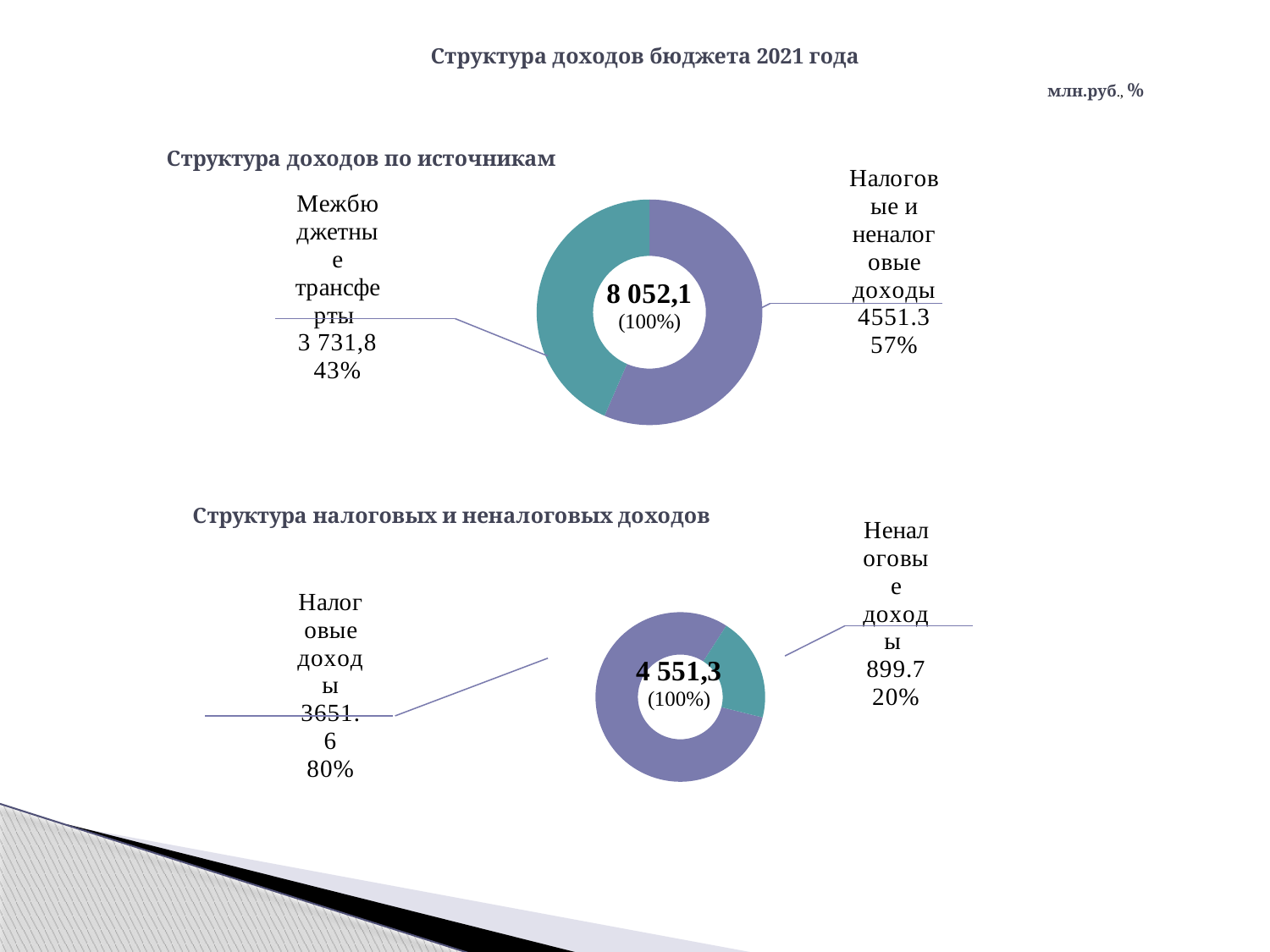
In the chart 'Структура доходов по источникам', what total is shown in the centre of the doughnut? 8 052,1 In the chart 'Структура доходов по источникам', which category is the largest? Налоговые и неналоговые доходы In the chart 'Структура налоговых и неналоговых доходов', what total is shown in the centre of the doughnut? 4 551,3 In the chart 'Структура налоговых и неналоговых доходов', what is the value for 'Неналоговые доходы'? 899.7 In the chart 'Структура доходов по источникам', what is the difference in percentage points between 'Налоговые и неналоговые доходы' and 'Межбюджетные трансферты'? 14 In the chart 'Структура доходов по источникам', what is the value for 'Межбюджетные трансферты'? 3 731,8 In the chart 'Структура доходов по источникам', what share of the total do 'Налоговые и неналоговые доходы' make up? 57% What is the main title of the slide? Структура доходов бюджета 2021 года What type of chart is used for 'Структура доходов по источникам'? Doughnut chart How many categories does the chart 'Структура налоговых и неналоговых доходов' show? 2 In the chart 'Структура налоговых и неналоговых доходов', which category is the smallest? Неналоговые доходы In the chart 'Структура налоговых и неналоговых доходов', what share do 'Налоговые доходы' make up? 80%